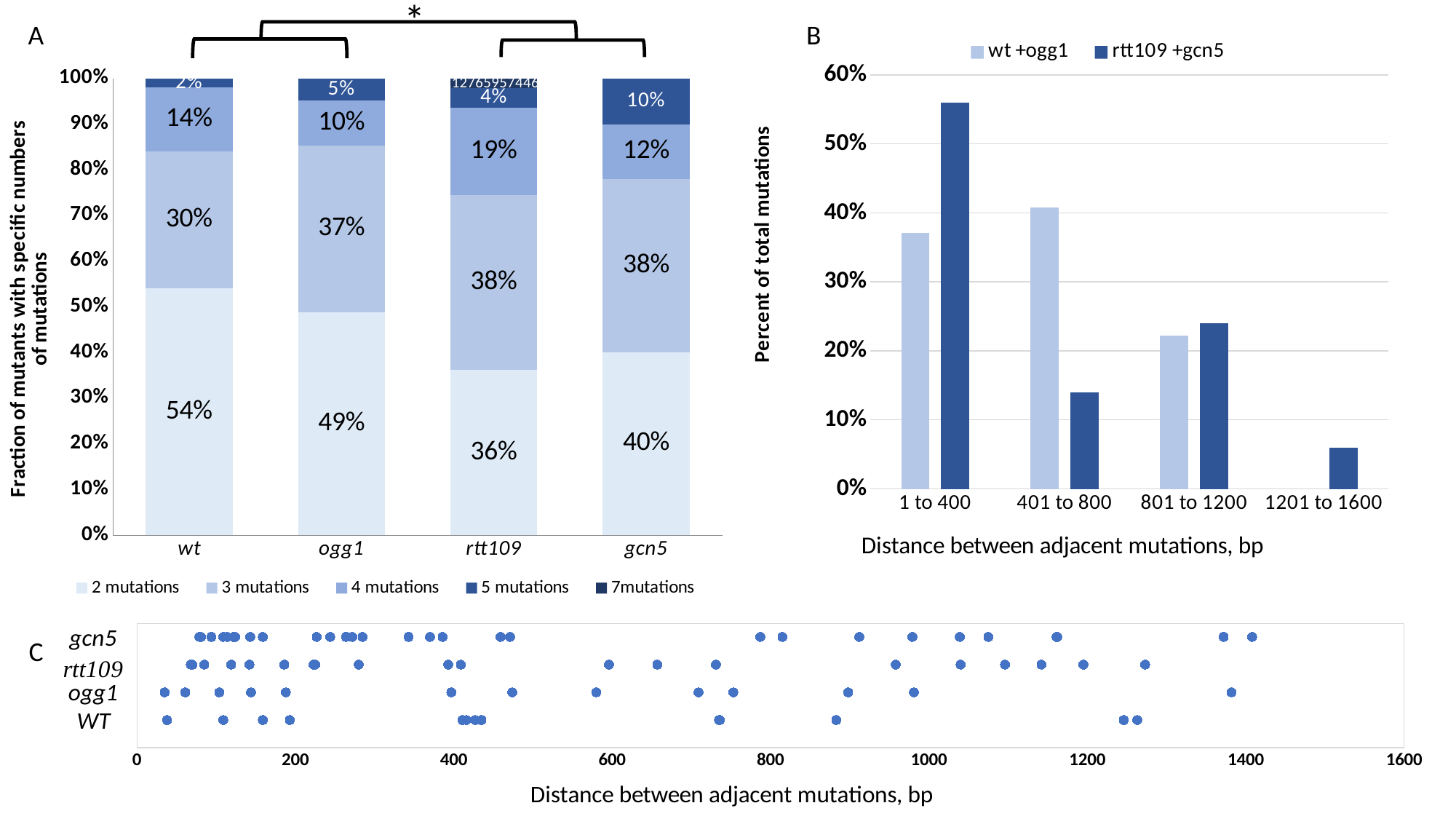
In chart A, which is larger: the 2-mutations share for ogg1 or for gcn5? ogg1 In chart B, is the value for wt +ogg1 in the 1 to 400 bin greater or less than 40%? less In chart B, is the value for rtt109 +gcn5 in the 1201 to 1600 bin greater or less than 10%? less In chart A, what percentage of rtt109 mutants have 4 mutations? 19% What kind of chart is chart C? Dot plot (scatter chart) In chart A, what percentage of wt mutants have 2 mutations? 54% In chart B, is the value for rtt109 +gcn5 in the 1 to 400 bin greater or less than 50%? greater In chart A, which strain has the lowest fraction of mutants with 2 mutations? rtt109 In chart B, how many distance bins are shown on the x axis? 4 In chart A, how many series does the legend list? 5 In chart A, what is the difference between the 3-mutations share for ogg1 and for wt? 7%